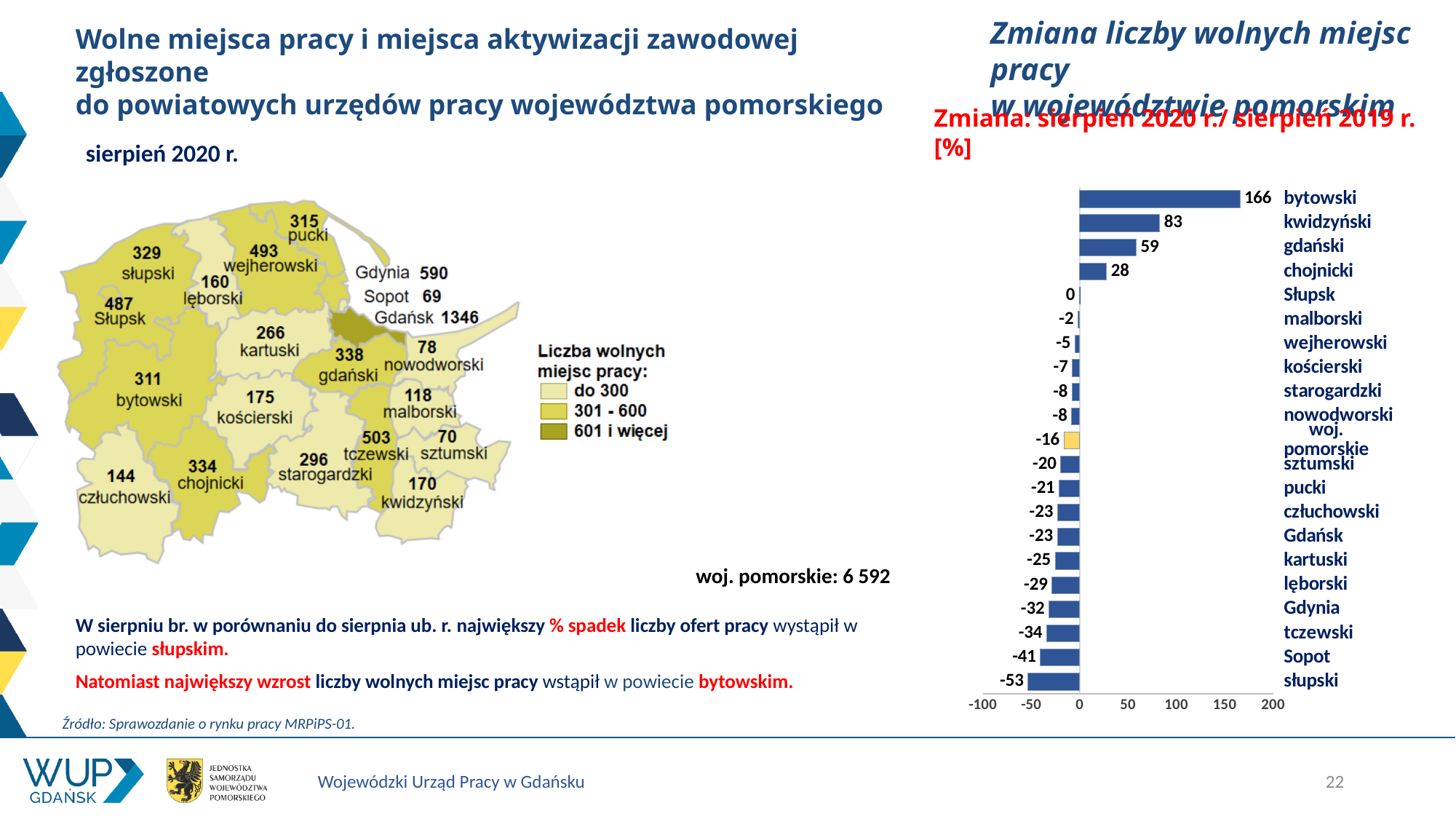
In the bar chart on the right, what is the value for woj. pomorskie? -16 In the bar chart on the right, which category has the lowest value? słupski In the bar chart on the right, which category has the highest value? bytowski What kind of chart is shown on the right side of the slide? bar chart How many categories are shown in the bar chart on the right? 21 In the bar chart on the right, what is the value for Gdynia? -32 In the bar chart on the right, what is the value for Sopot? -41 In the bar chart on the right, what is the value for bytowski? 166 In the bar chart on the right, which bar is coloured differently (yellow) from the others? woj. pomorskie In the bar chart on the right, is the value for bytowski greater or less than 150? greater In the bar chart on the right, what is the difference between the values for bytowski and kwidzyński? 83 In the bar chart on the right, which is larger, the value for gdański or the value for chojnicki? gdański